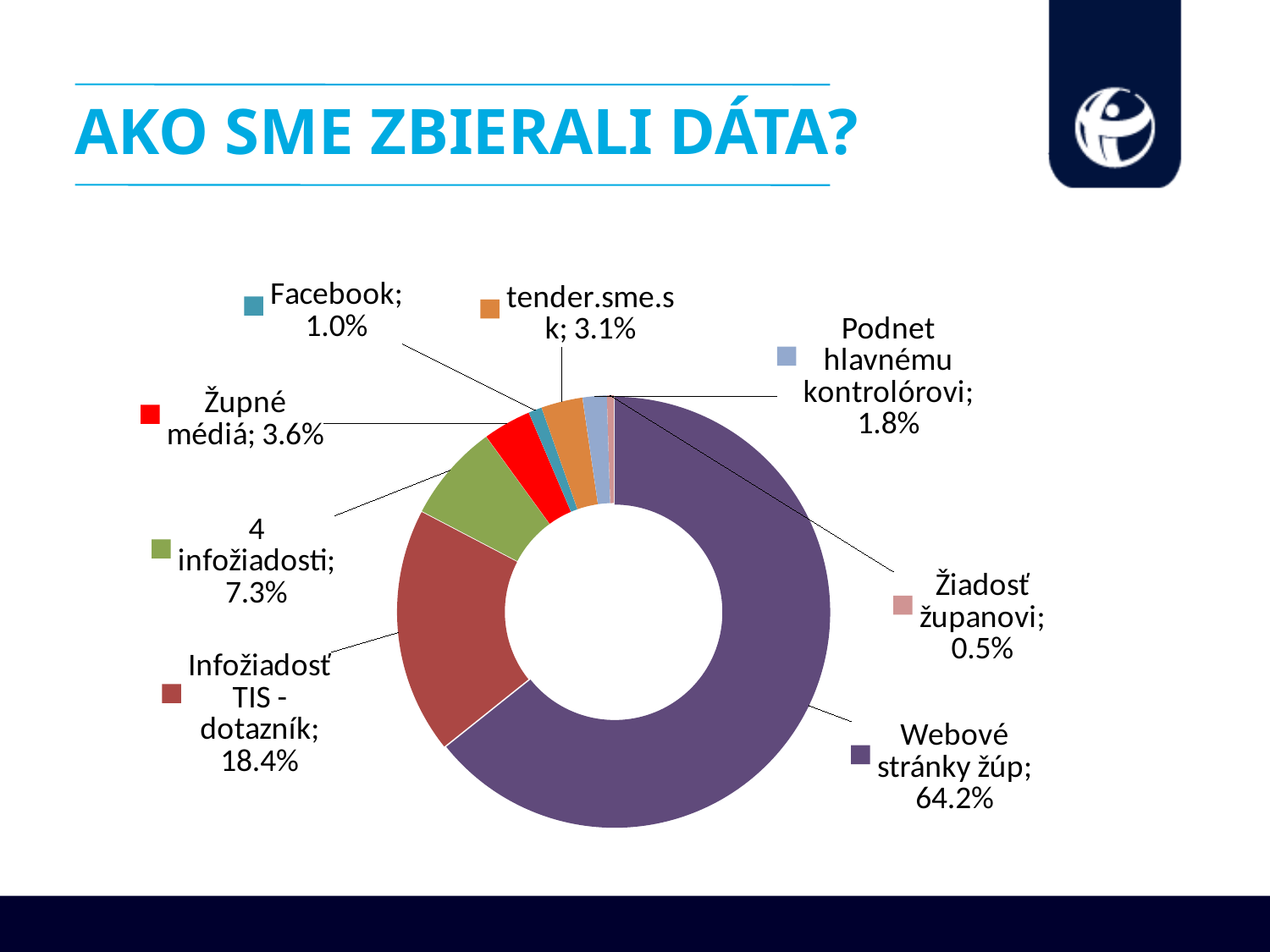
What share does "Webové stránky žúp" have in the chart? 64.2% Which is larger, the share for "Župné médiá" or the share for "tender.sme.sk"? Župné médiá What is the title of the slide containing the chart? AKO SME ZBIERALI DÁTA? What is the value shown for "tender.sme.sk"? 3.1% What is the difference between the shares of "Webové stránky žúp" and "Infožiadosť TIS - dotazník"? 45.8% What is the value shown for "Podnet hlavnému kontrolórovi"? 1.8% Which category has the smallest share in the chart? Žiadosť županovi Which category has the largest share in the chart? Webové stránky žúp How many categories are shown in the chart? 8 What kind of chart is shown on the slide? Doughnut (pie) chart What is the value shown for "4 infožiadosti"? 7.3% What is the value shown for "Infožiadosť TIS - dotazník"? 18.4%